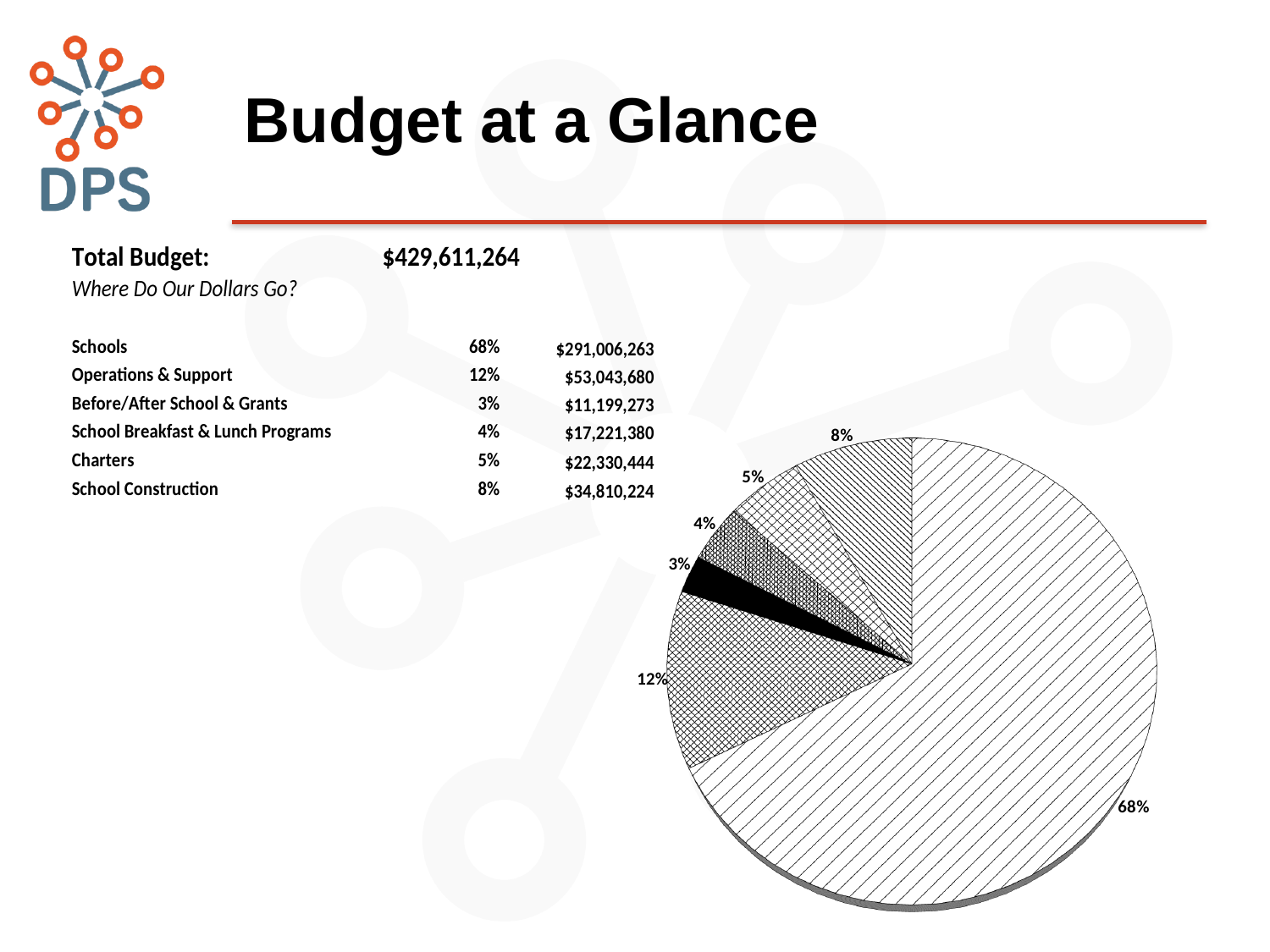
What is the dollar amount for Charters? $22,330,444 Which is larger, the share for Charters or the share for School Breakfast & Lunch Programs? Charters What is the total budget shown on the slide? $429,611,264 What is the difference in percentage points between the Schools share and the Operations & Support share? 56% Which budget category has the largest share of the pie chart? Schools Which budget category has the smallest share of the pie chart? Before/After School & Grants What share of the budget does the largest slice of the pie chart represent? 68% How many slices does the pie chart have? 6 What percentage of the budget goes to School Construction? 8% What is the dollar amount for School Breakfast & Lunch Programs? $17,221,380 What percentage of the budget goes to Operations & Support? 12% What kind of chart is shown on the slide? pie chart